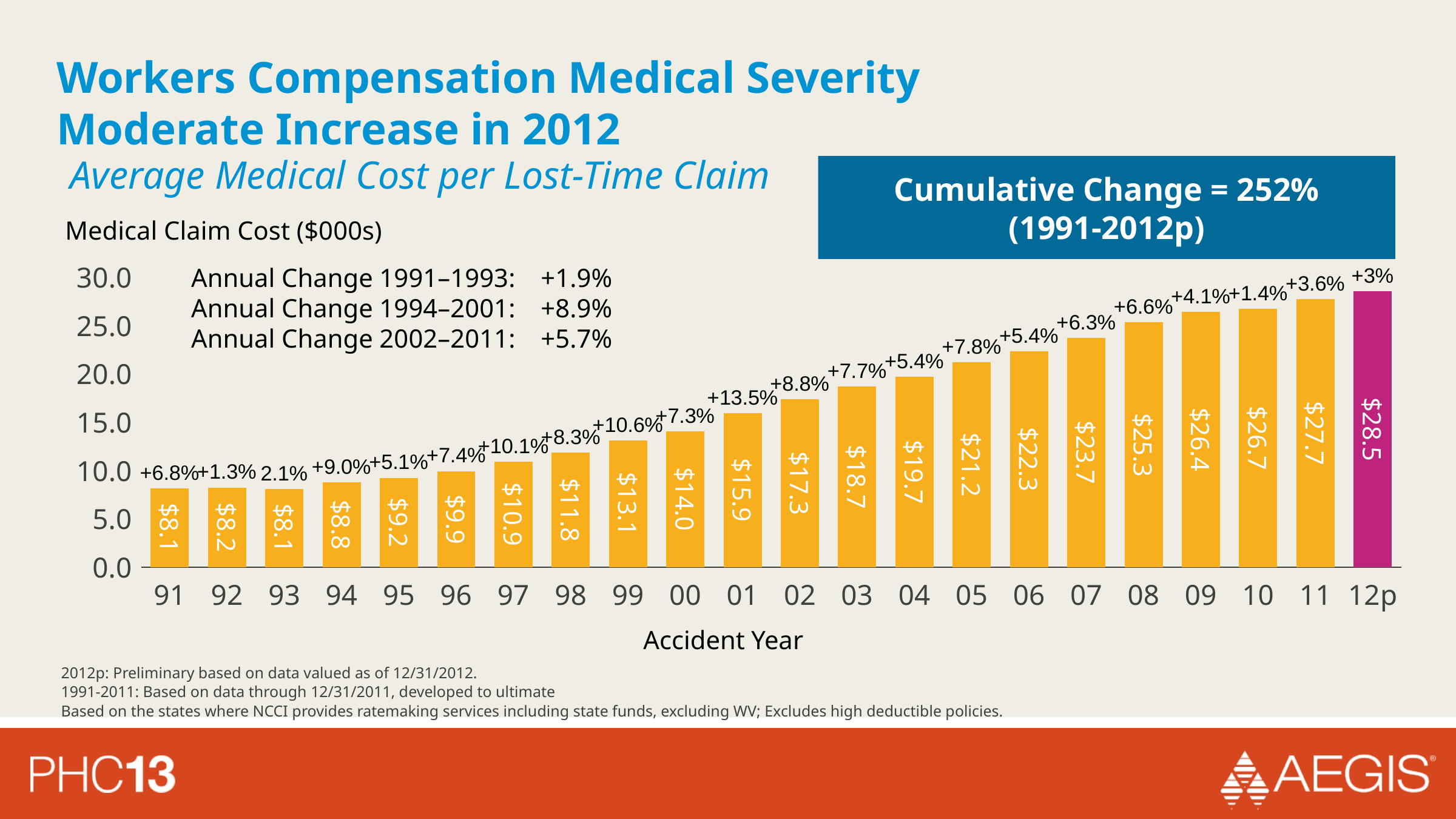
What is the medical claim cost shown for accident year 99? $13.1 What is the difference between the medical claim cost for accident year 11 and accident year 10? $1.0 Which accident year has the highest average medical cost per lost-time claim? 12p How many accident years are plotted in the chart? 22 What is the average medical cost per lost-time claim for accident year 2012p? $28.5 What cumulative change from 1991 to 2012p is stated on the slide? 252% What is the difference between the medical claim cost for 12p and for 91? $20.4 Which accident year has the larger medical claim cost, 04 or 05? 05 What annual percentage change is labeled above the bar for accident year 01? +13.5% Is the medical claim cost for accident year 01 greater or less than 15.0? greater What kind of chart is used to show the average medical cost per lost-time claim? bar chart Do the medical claim costs generally rise or fall from accident year 91 to 12p? rise